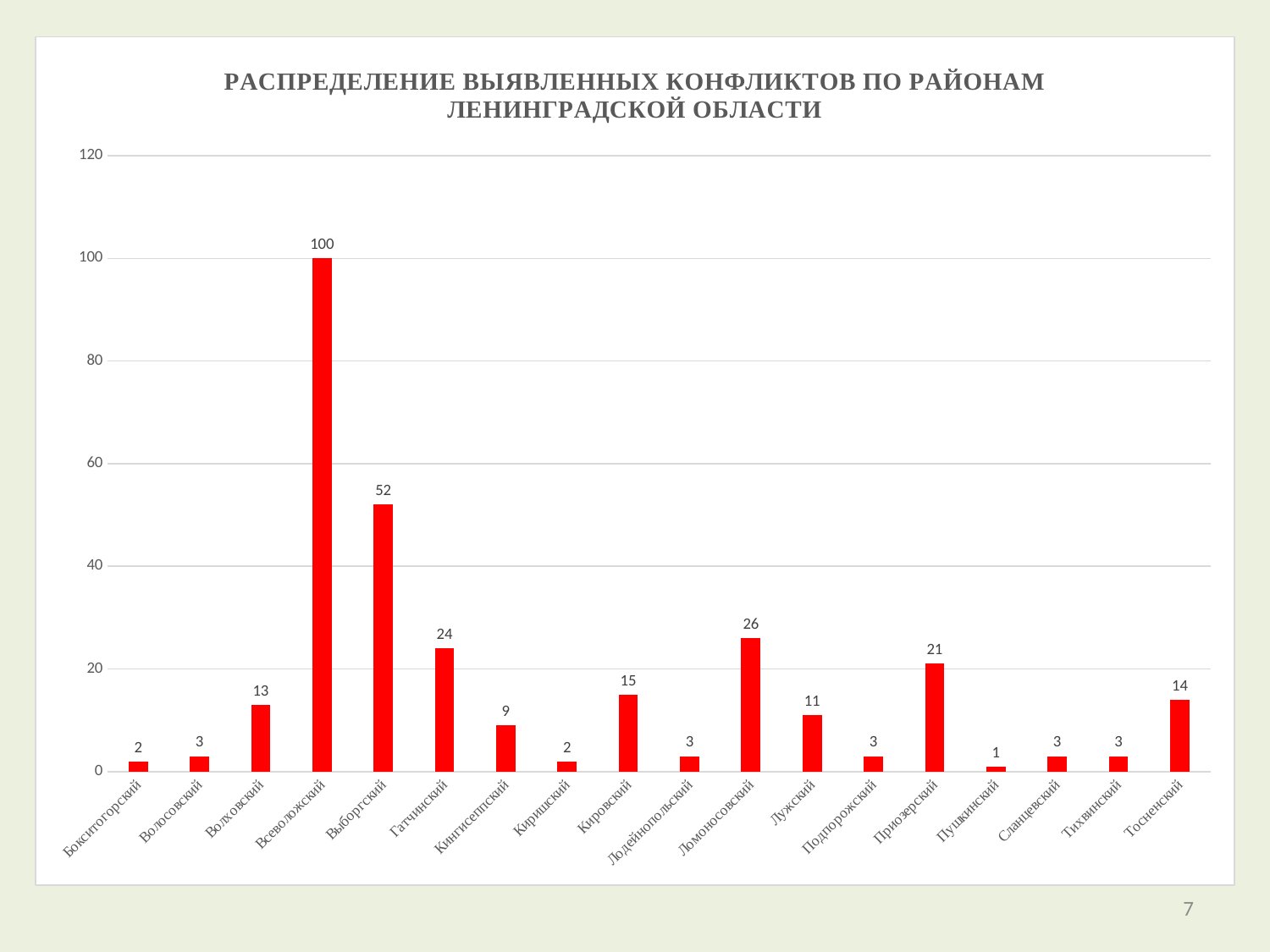
What is the value for Приозерский? 21 What is the value for Выборгский? 52 What is the title of the chart? РАСПРЕДЕЛЕНИЕ ВЫЯВЛЕННЫХ КОНФЛИКТОВ ПО РАЙОНАМ ЛЕНИНГРАДСКОЙ ОБЛАСТИ Is the value for Выборгский greater or less than 40? greater How many districts are shown on the x axis? 18 What is the difference between the values for Всеволожский and Выборгский? 48 What is the value for Ломоносовский? 26 What is the value for Всеволожский? 100 What kind of chart is shown on the slide? bar chart Which district has the highest value? Всеволожский Which district has the lowest value? Пушкинский Which is larger, the value for Гатчинский or the value for Кировский? Гатчинский